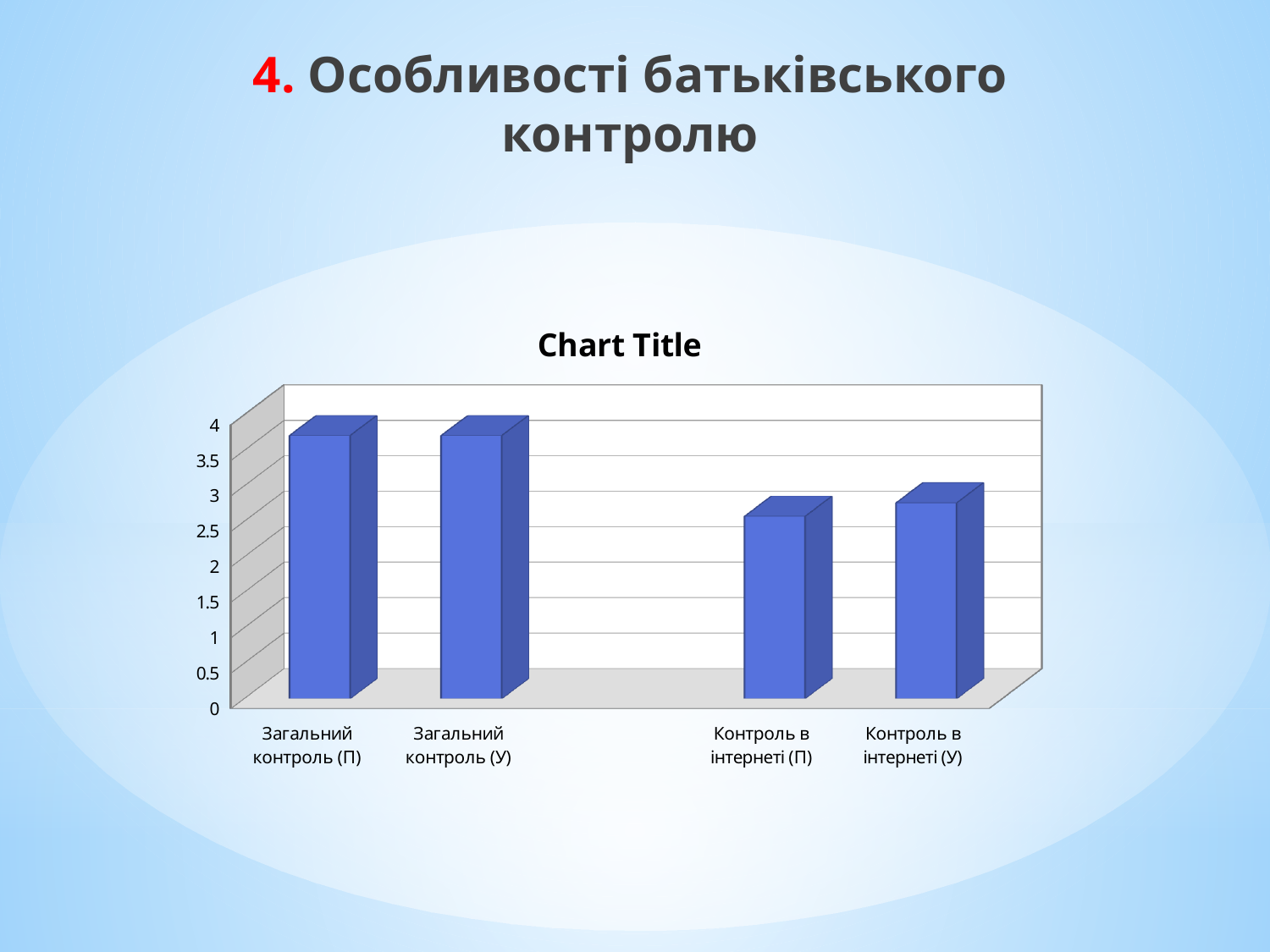
What is the highest value shown on the vertical axis? 4 What kind of chart is shown on the slide? bar chart Is the value for Загальний контроль (У) greater or less than 3? greater Is the value for Контроль в інтернеті (П) greater or less than 3? less Which is larger, the value for Загальний контроль (У) or the value for Контроль в інтернеті (У)? Загальний контроль (У) Which category has the lowest value? Контроль в інтернеті (П) Is the value for Загальний контроль (П) greater or less than 3? greater How many categories are plotted on the chart? 4 What is the title of the chart? Chart Title Which is larger, the value for Загальний контроль (П) or the value for Контроль в інтернеті (П)? Загальний контроль (П)